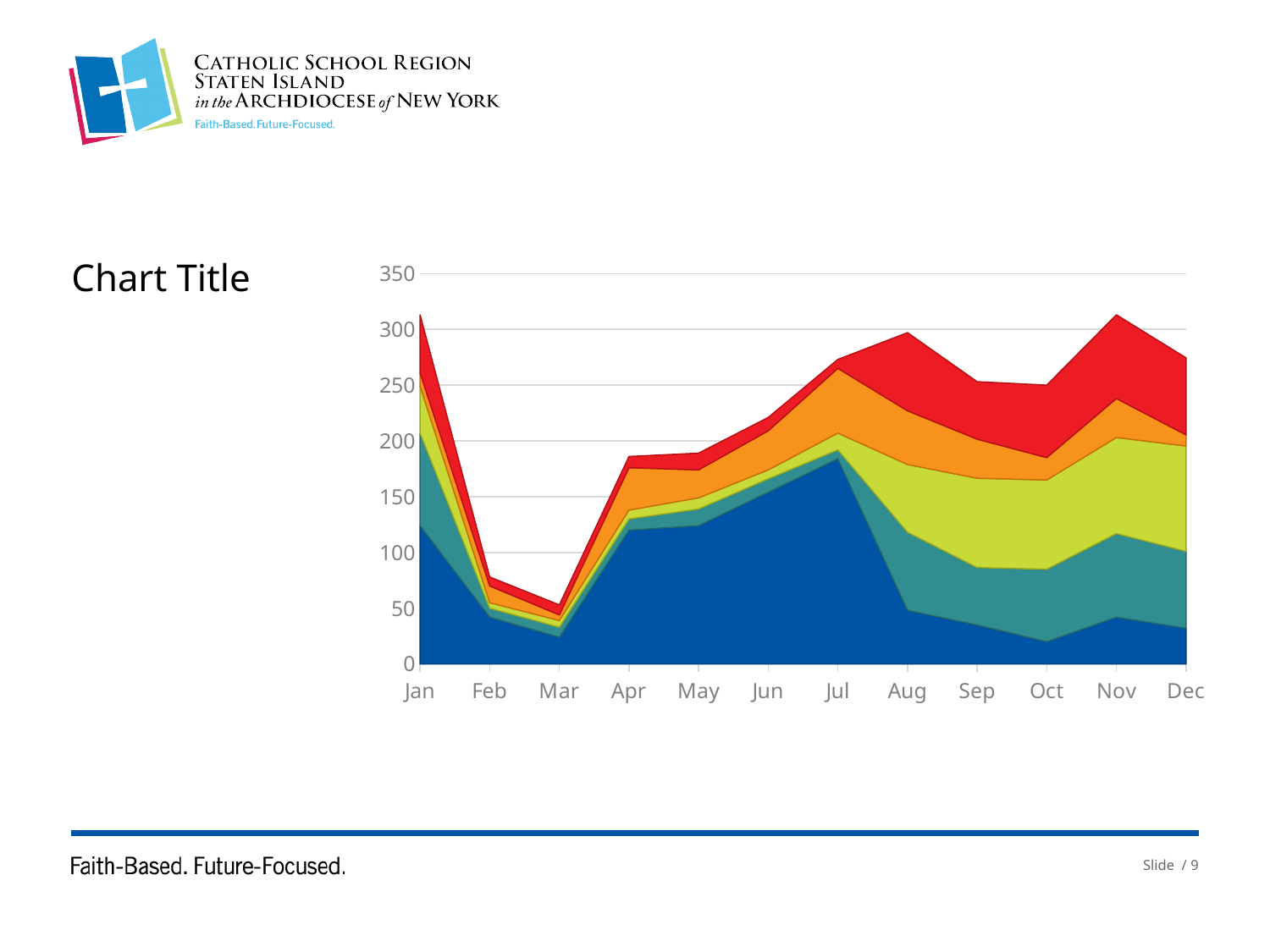
How many months are shown along the x axis of the chart? 12 What kind of chart is shown on the slide? stacked area chart Does the bottom (blue) series rise or fall from Jul to Oct? fall Is the value of the bottom (blue) series for Jul greater or less than 150? greater Is the total stacked value for Mar greater or less than 100? less In which month does the bottom (blue) series reach its highest value? Jul Is the total stacked value for Jul greater or less than 250? greater Which month has the larger total stacked value, Aug or Sep? Aug In which month is the total stacked value lowest? Mar What is the title of the chart? Chart Title How many coloured series (bands) are stacked in the chart? 5